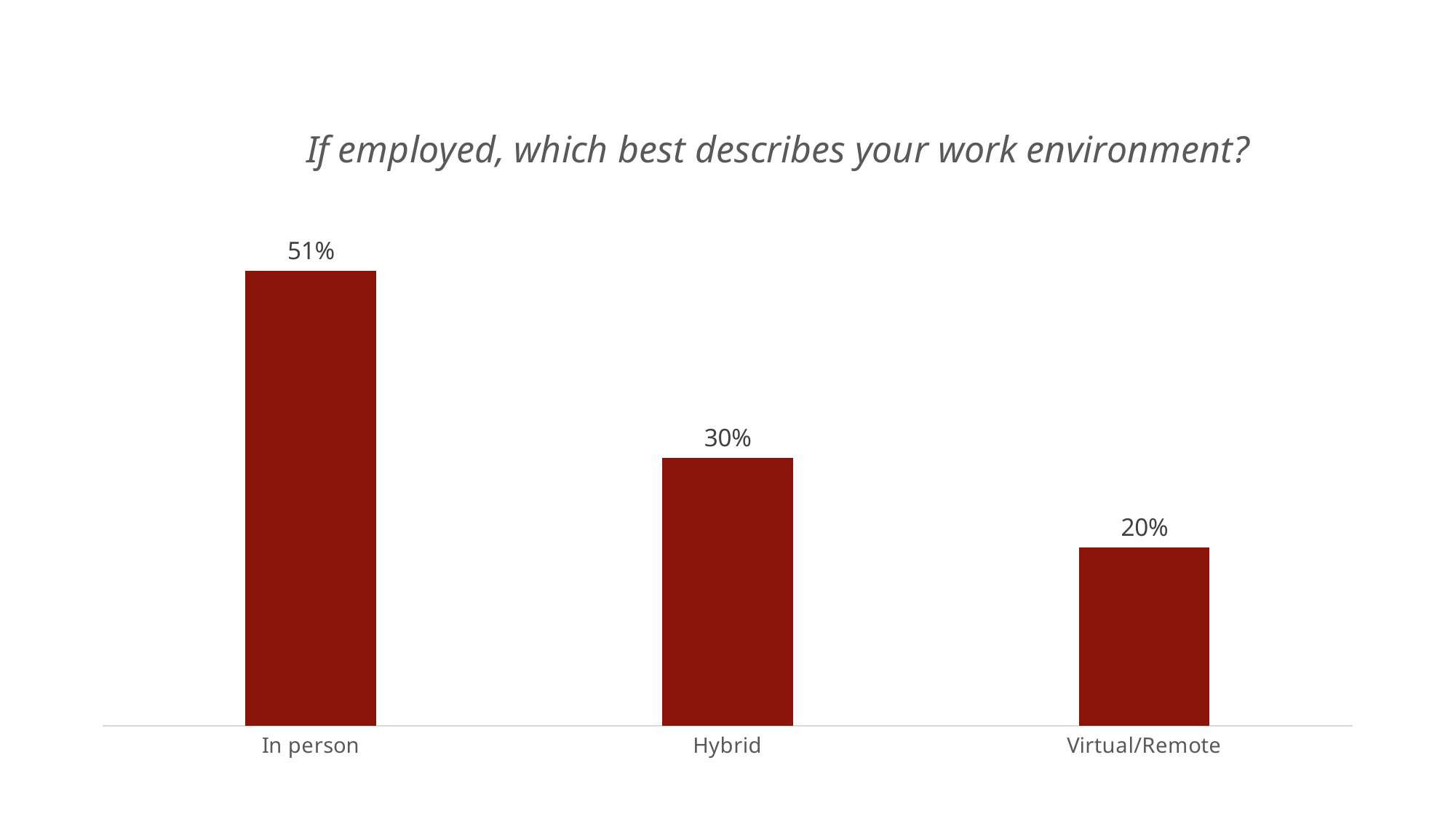
What is the difference between the In person and Hybrid values? 21% Which is larger, the value for Hybrid or the value for Virtual/Remote? Hybrid What is the value for Hybrid? 30% Which work environment has the lowest percentage? Virtual/Remote What percentage of respondents work in person? 51% How many categories are shown on the chart? 3 Which work environment has the highest percentage? In person What is the value for Virtual/Remote? 20% What kind of chart is shown on the slide? Bar chart Do the values rise or fall from left to right across the categories? Fall What is the difference between the Hybrid and Virtual/Remote values? 10% What is the title of the chart? If employed, which best describes your work environment?